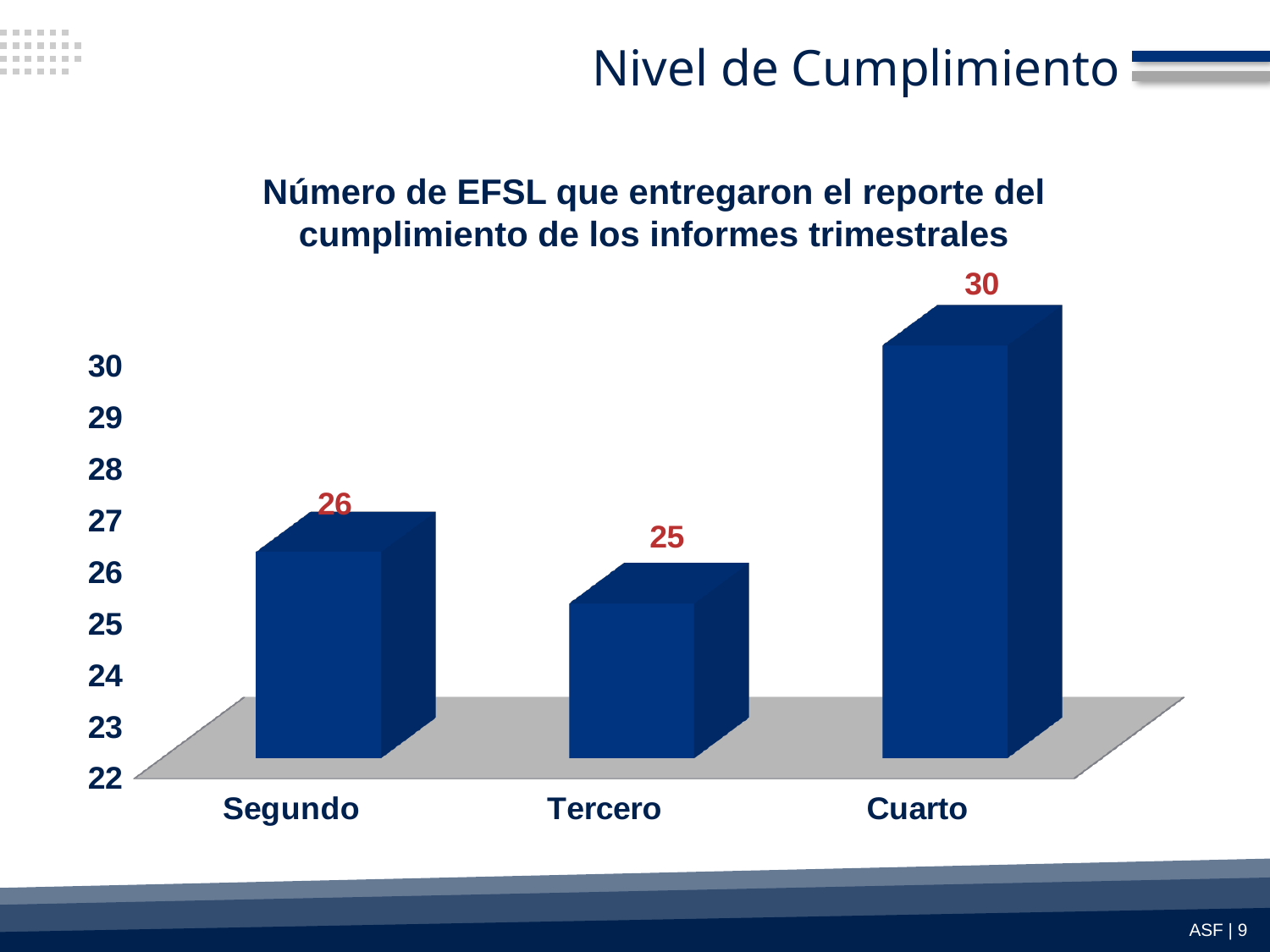
What is the difference between the values for Segundo and Tercero? 1 Which is larger, the value for Segundo or the value for Cuarto? Cuarto What is the value for Tercero? 25 What kind of chart is shown on the slide? bar chart What is the value for Segundo? 26 What is the title of the chart? Número de EFSL que entregaron el reporte del cumplimiento de los informes trimestrales What is the difference between the values for Cuarto and Tercero? 5 How many categories are shown on the x axis? 3 What is the value for Cuarto? 30 Which category has the lowest value? Tercero Is the value for Cuarto greater or less than 28? greater Which category has the highest value? Cuarto